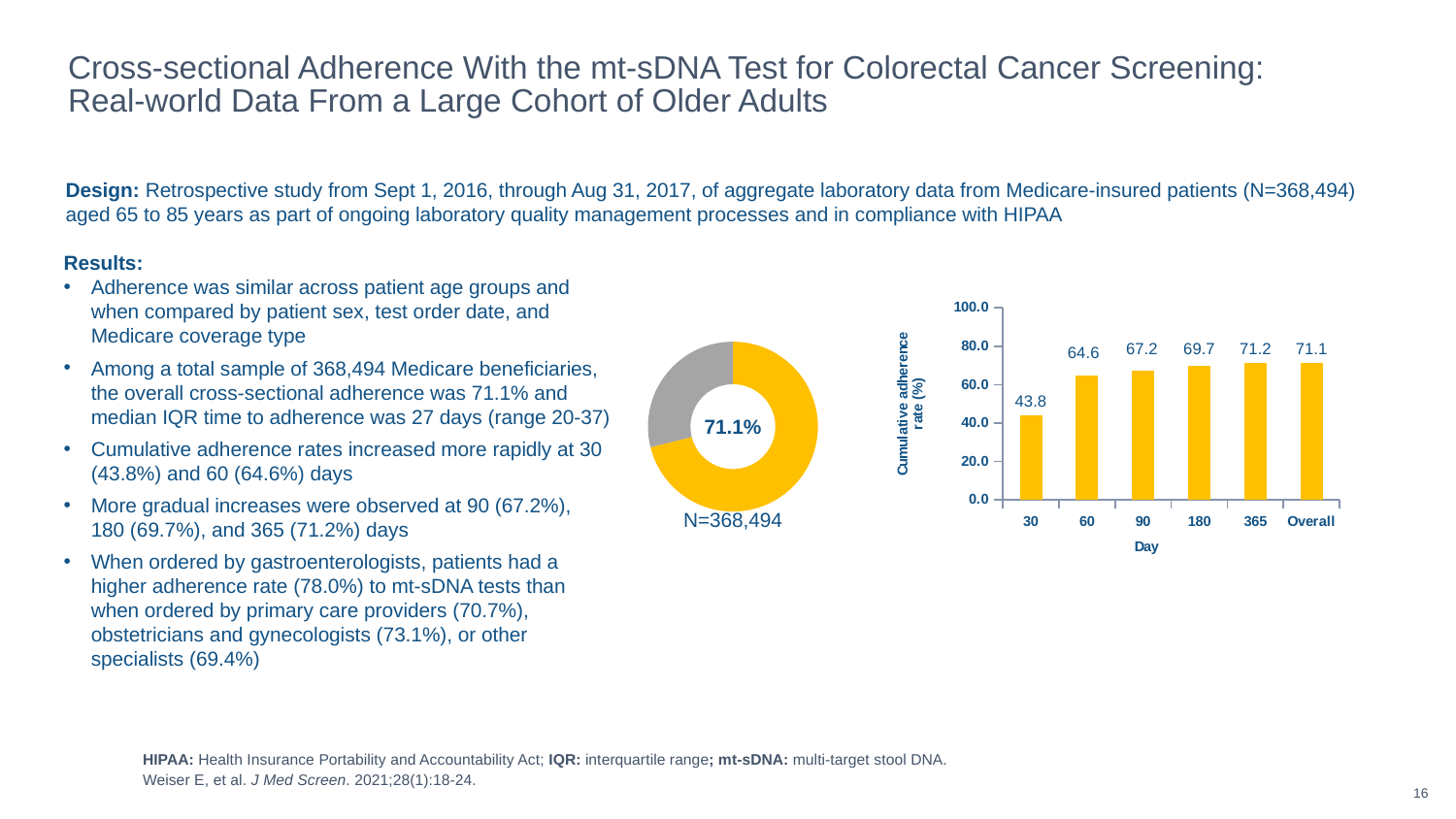
In the bar chart on the right, is the cumulative adherence rate higher at day 180 or at day 90? 180 In the bar chart on the right, what is the value shown for the Overall bar? 71.1 In the bar chart on the right, do the cumulative adherence rates rise or fall from day 30 to day 365? rise In the bar chart on the right, how many bars are plotted? 6 In the bar chart on the right, what is the difference between the cumulative adherence rate at day 60 and at day 30? 20.8 In the bar chart on the right, what is the cumulative adherence rate at day 60? 64.6 What type of chart is shown on the left of the slide, labeled N=368,494? donut chart In the bar chart on the right, which day category has the highest cumulative adherence rate? 365 In the bar chart on the right, what is the cumulative adherence rate at day 30? 43.8 What percentage is printed in the center of the donut chart on the left? 71.1% In the bar chart on the right, which day category has the lowest cumulative adherence rate? 30 In the bar chart on the right, what is the difference between the cumulative adherence rate at day 365 and at day 90? 4.0